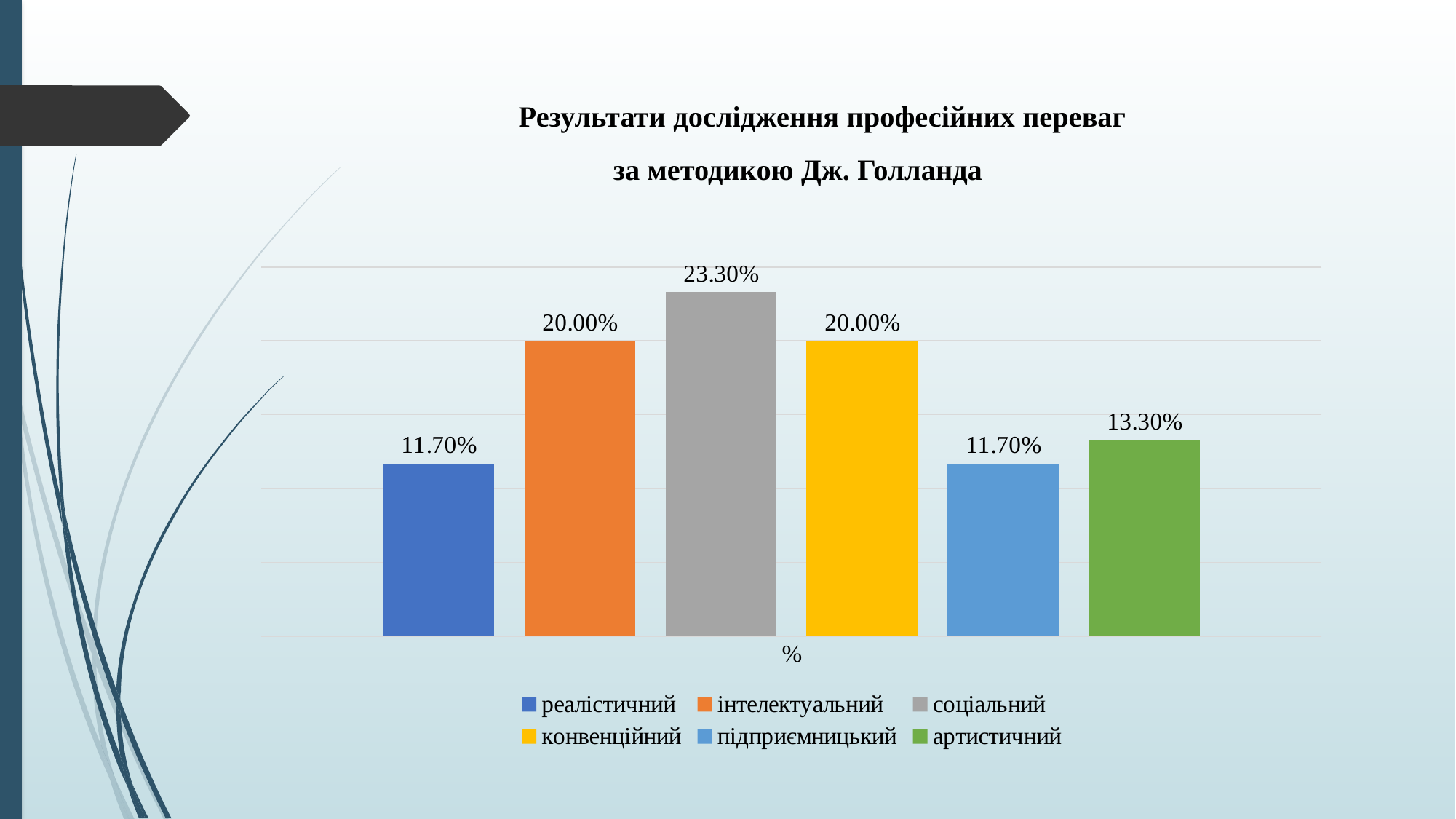
What value is shown for артистичний? 13.30% How many series does the legend list? 6 What value is shown for підприємницький? 11.70% What colour is the bar for конвенційний? yellow What value is shown for соціальний? 23.30% Which is larger, the value for інтелектуальний or the value for артистичний? інтелектуальний What value is shown for інтелектуальний? 20.00% What is the difference between the values for соціальний and конвенційний? 3.30% What kind of chart is shown on the slide? bar chart Which series has the highest value? соціальний Which is larger, the value for артистичний or the value for підприємницький? артистичний What is the difference between the values for артистичний and реалістичний? 1.60%